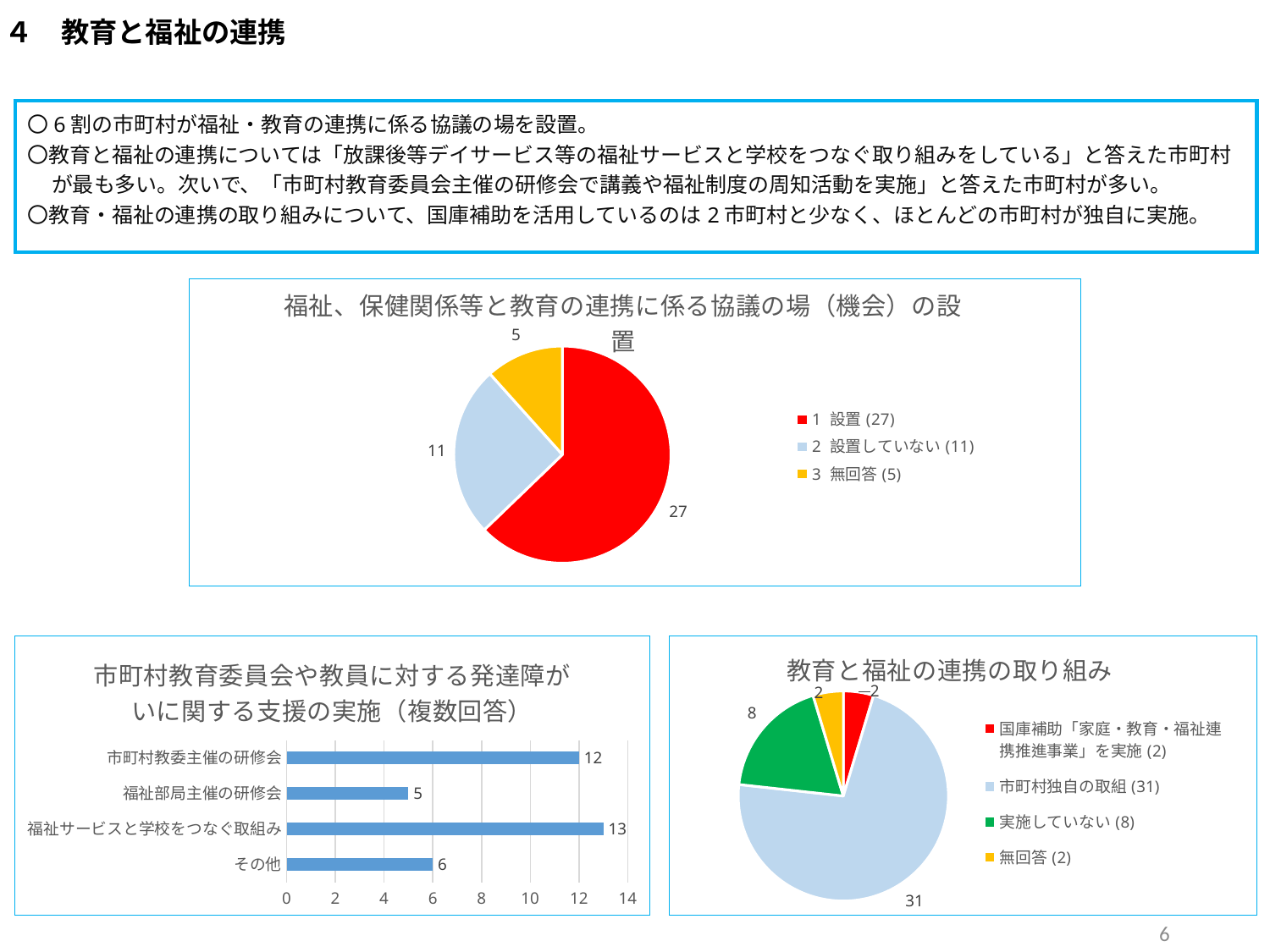
In the bottom-left chart (市町村教育委員会や教員に対する発達障がいに関する支援の実施), how many categories are plotted? 4 In the top pie chart (福祉、保健関係等と教育の連携に係る協議の場（機会）の設置), how many categories does the legend list? 3 In the bottom-right pie chart (教育と福祉の連携の取り組み), what is the value for 実施していない? 8 In the bottom-right pie chart (教育と福祉の連携の取り組み), what colour is the slice for 実施していない? green In the bottom-right pie chart (教育と福祉の連携の取り組み), what is the value for 市町村独自の取組? 31 In the bottom-left chart (市町村教育委員会や教員に対する発達障がいに関する支援の実施), what is the value for 福祉部局主催の研修会? 5 In the bottom-left chart (市町村教育委員会や教員に対する発達障がいに関する支援の実施), which is larger: 市町村教委主催の研修会 or その他? 市町村教委主催の研修会 In the top pie chart (福祉、保健関係等と教育の連携に係る協議の場（機会）の設置), what is the difference between 設置 and 設置していない? 16 In the top pie chart (福祉、保健関係等と教育の連携に係る協議の場（機会）の設置), what is the value for 設置? 27 In the top pie chart (福祉、保健関係等と教育の連携に係る協議の場（機会）の設置), which category has the smallest slice? 無回答 In the bottom-left chart (市町村教育委員会や教員に対する発達障がいに関する支援の実施), what kind of chart is shown? bar chart In the bottom-left chart (市町村教育委員会や教員に対する発達障がいに関する支援の実施), which category has the highest value? 福祉サービスと学校をつなぐ取組み